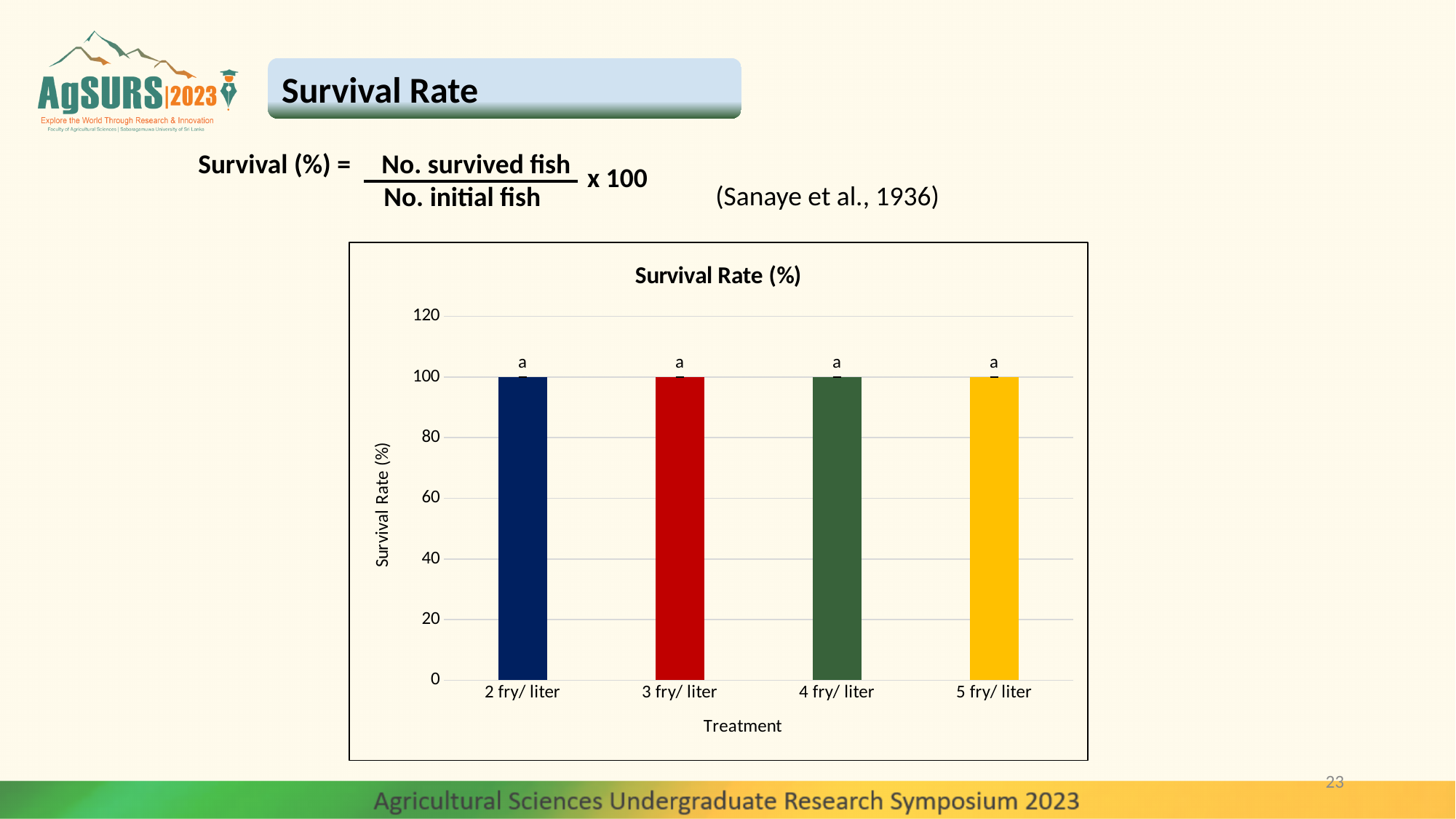
How many treatment categories are shown on the x axis of the chart? 4 Is the value for 3 fry/ liter greater or less than 120? less What is the survival rate for the 5 fry/ liter treatment? 100 Is the value for 4 fry/ liter greater or less than 80? greater Do the survival rate values rise, fall, or stay the same across the treatments from 2 fry/ liter to 5 fry/ liter? stay the same What is the survival rate for the 3 fry/ liter treatment? 100 What is the survival rate for the 2 fry/ liter treatment? 100 What type of chart is shown on the slide? bar chart What is the label of the x axis of the chart? Treatment What is the difference between the survival rate for 2 fry/ liter and 4 fry/ liter? 0 What is the title of the chart? Survival Rate (%)